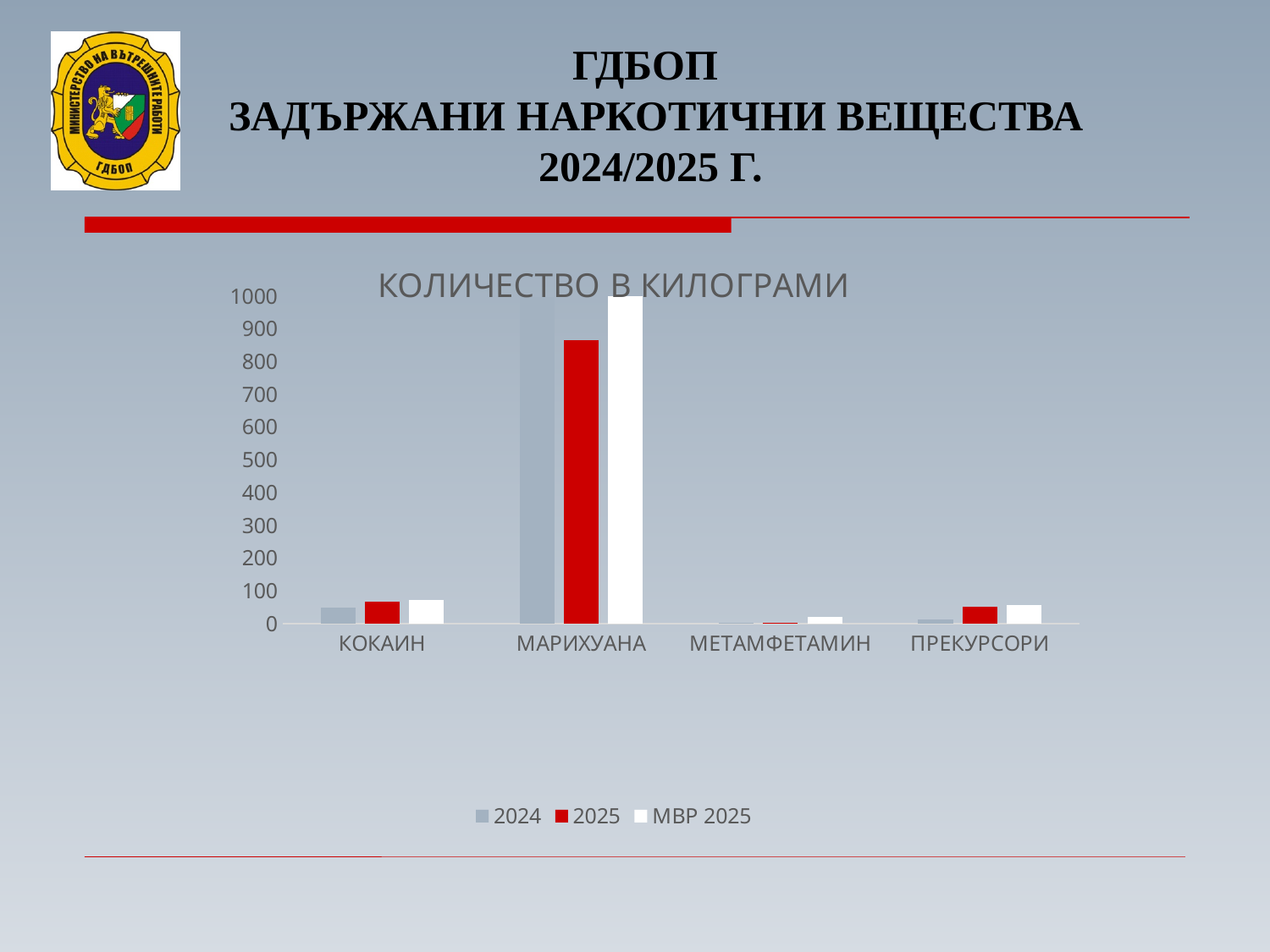
Is the 2025 value for КОКАИН greater or less than 100? less Which series is shown in red in the chart? 2025 For МАРИХУАНА, which is larger: the 2024 value or the 2025 value? 2024 How many series does the chart legend list? 3 For ПРЕКУРСОРИ, which is larger: the 2024 value or the 2025 value? 2025 What kind of chart is shown on the slide? bar chart What is the title of the chart? КОЛИЧЕСТВО В КИЛОГРАМИ Which category has the highest value for the 2025 series? МАРИХУАНА How many categories are shown on the x axis of the chart? 4 Is the 2025 value for МАРИХУАНА greater or less than 900? less Which category has the lowest value for the 2025 series? МЕТАМФЕТАМИН Is the 2025 value for МАРИХУАНА greater or less than 800? greater